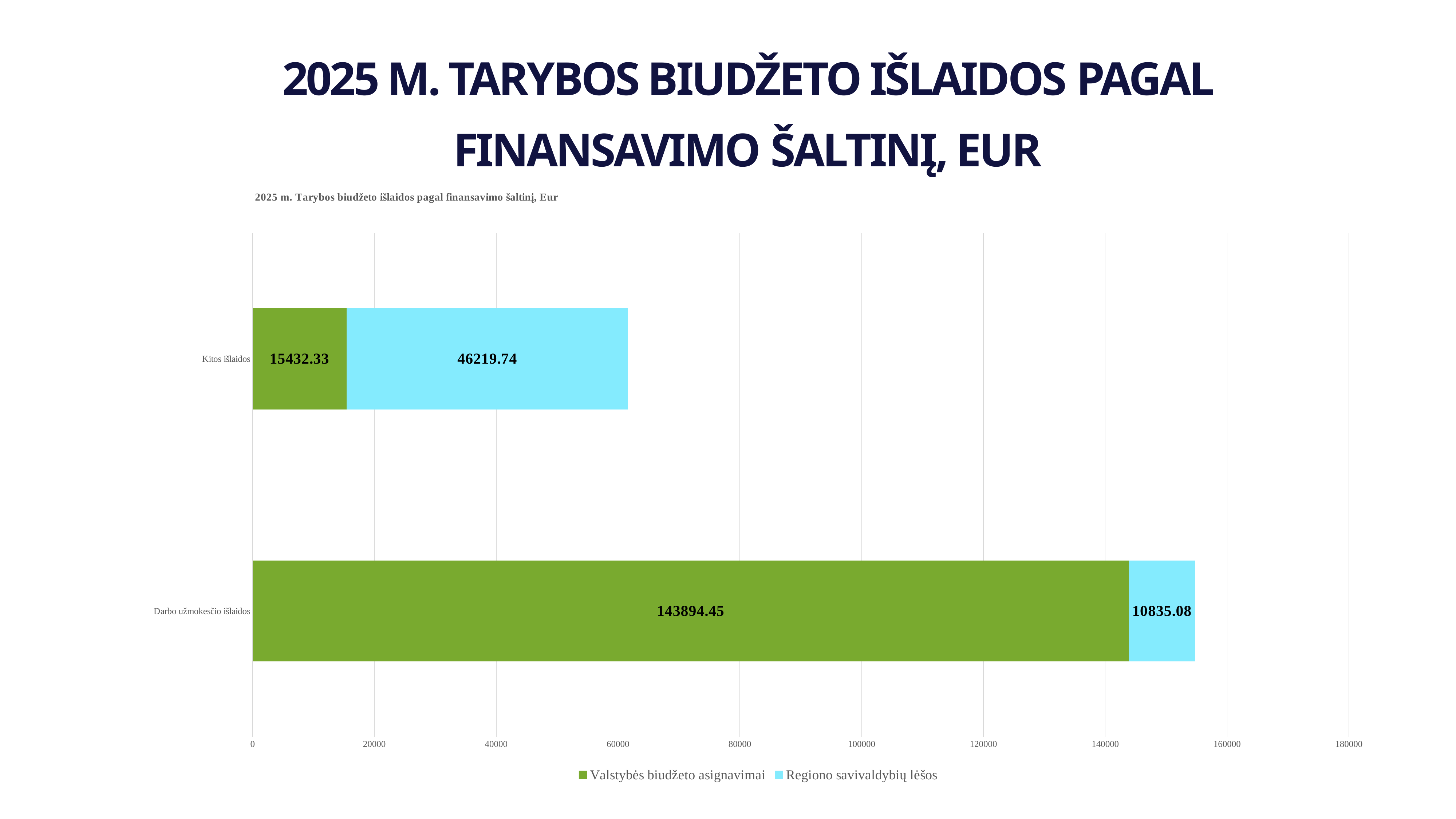
What is the value of Valstybės biudžeto asignavimai for Darbo užmokesčio išlaidos? 143894.45 Which category has the lower value for Regiono savivaldybių lėšos? Darbo užmokesčio išlaidos What kind of chart is shown on the slide? Stacked bar chart What is the value of Regiono savivaldybių lėšos for Darbo užmokesčio išlaidos? 10835.08 What is the value of Valstybės biudžeto asignavimai for Kitos išlaidos? 15432.33 What is the total of the stacked bar for Kitos išlaidos? 61652.07 What is the total of the stacked bar for Darbo užmokesčio išlaidos? 154729.53 How many series does the legend list? 2 Is the Regiono savivaldybių lėšos value for Kitos išlaidos larger than the Regiono savivaldybių lėšos value for Darbo užmokesčio išlaidos? Yes What is the value of Regiono savivaldybių lėšos for Kitos išlaidos? 46219.74 Which category has the higher value for Valstybės biudžeto asignavimai? Darbo užmokesčio išlaidos What is the difference between the Valstybės biudžeto asignavimai values for Darbo užmokesčio išlaidos and Kitos išlaidos? 128462.12